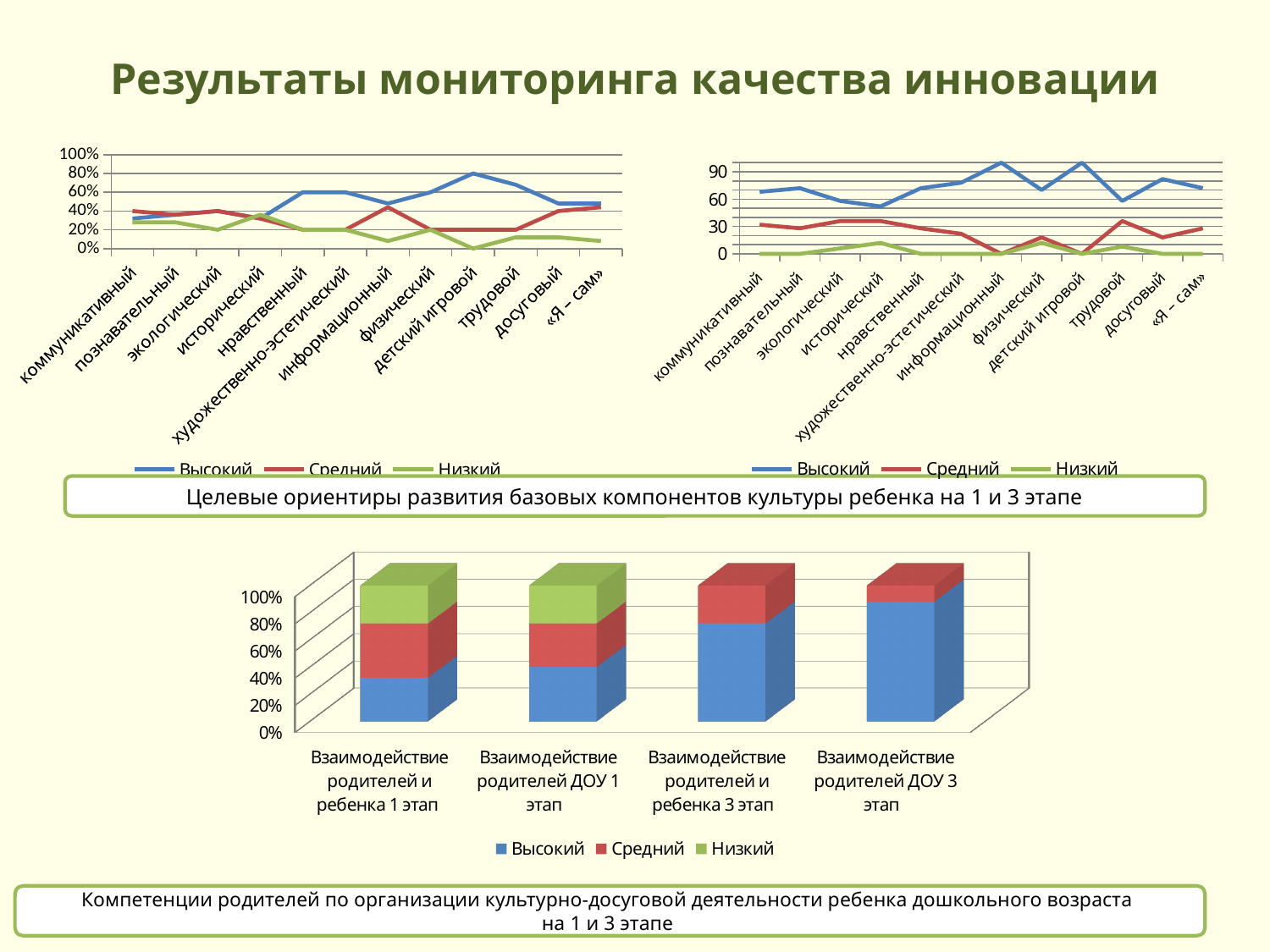
How many categories are shown in the bottom stacked bar chart? 4 In the top-left line chart, is the Высокий value for детский игровой greater or less than 60%? greater In the bottom stacked bar chart, which category has the largest Высокий segment? Взаимодействие родителей ДОУ 3 этап In the top-right line chart, is the Низкий value for исторический greater or less than 30? less In the top-left line chart, for which category does the Высокий series reach its highest value? детский игровой What kind of chart is the top-left chart on the slide? line chart How many series does the legend of the top-left line chart list? 3 What kind of chart is the bottom chart on the slide? bar chart How many categories are shown on the x axis of the top-right line chart? 12 In the top-right line chart, is the Высокий value for информационный greater or less than 90? greater In the bottom stacked bar chart, is the Высокий segment larger for Взаимодействие родителей и ребенка 1 этап or for Взаимодействие родителей и ребенка 3 этап? Взаимодействие родителей и ребенка 3 этап